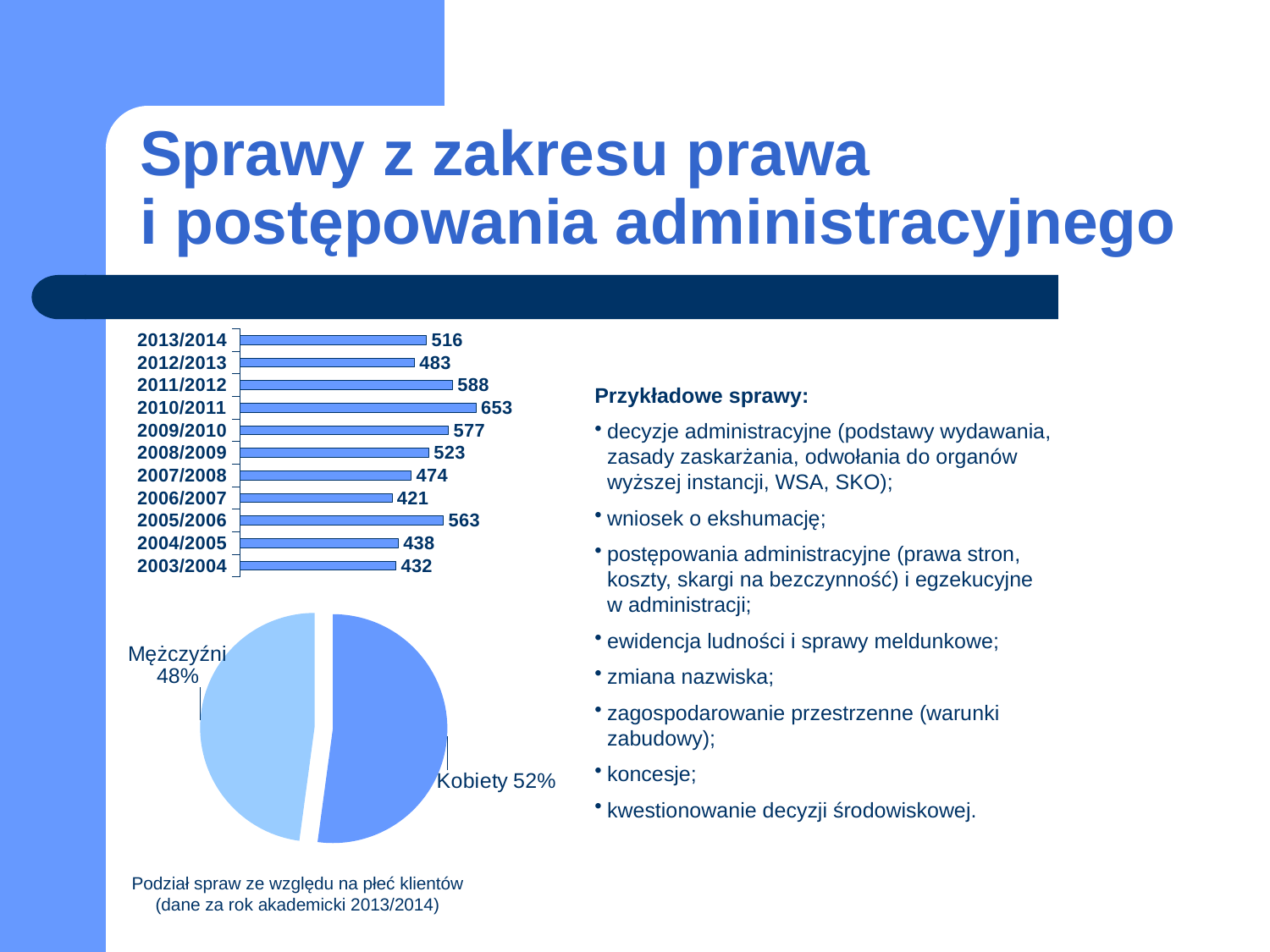
In the pie chart, which slice is larger: Kobiety or Mężczyźni? Kobiety In the bar chart, what is the difference between the values for 2013/2014 and 2012/2013? 33 In the pie chart, what share is labelled for Kobiety? 52% In the bar chart, which is larger: the value for 2005/2006 or the value for 2009/2010? 2009/2010 In the bar chart, what is the value for 2010/2011? 653 In the pie chart, what share is labelled for Mężczyźni? 48% How many academic years are shown in the bar chart? 11 In the bar chart, which academic year has the highest value? 2010/2011 In the bar chart, which academic year has the lowest value? 2006/2007 What kind of chart is the lower chart on the slide? pie chart What kind of chart is the upper chart on the slide? bar chart In the bar chart, what is the value for 2003/2004? 432